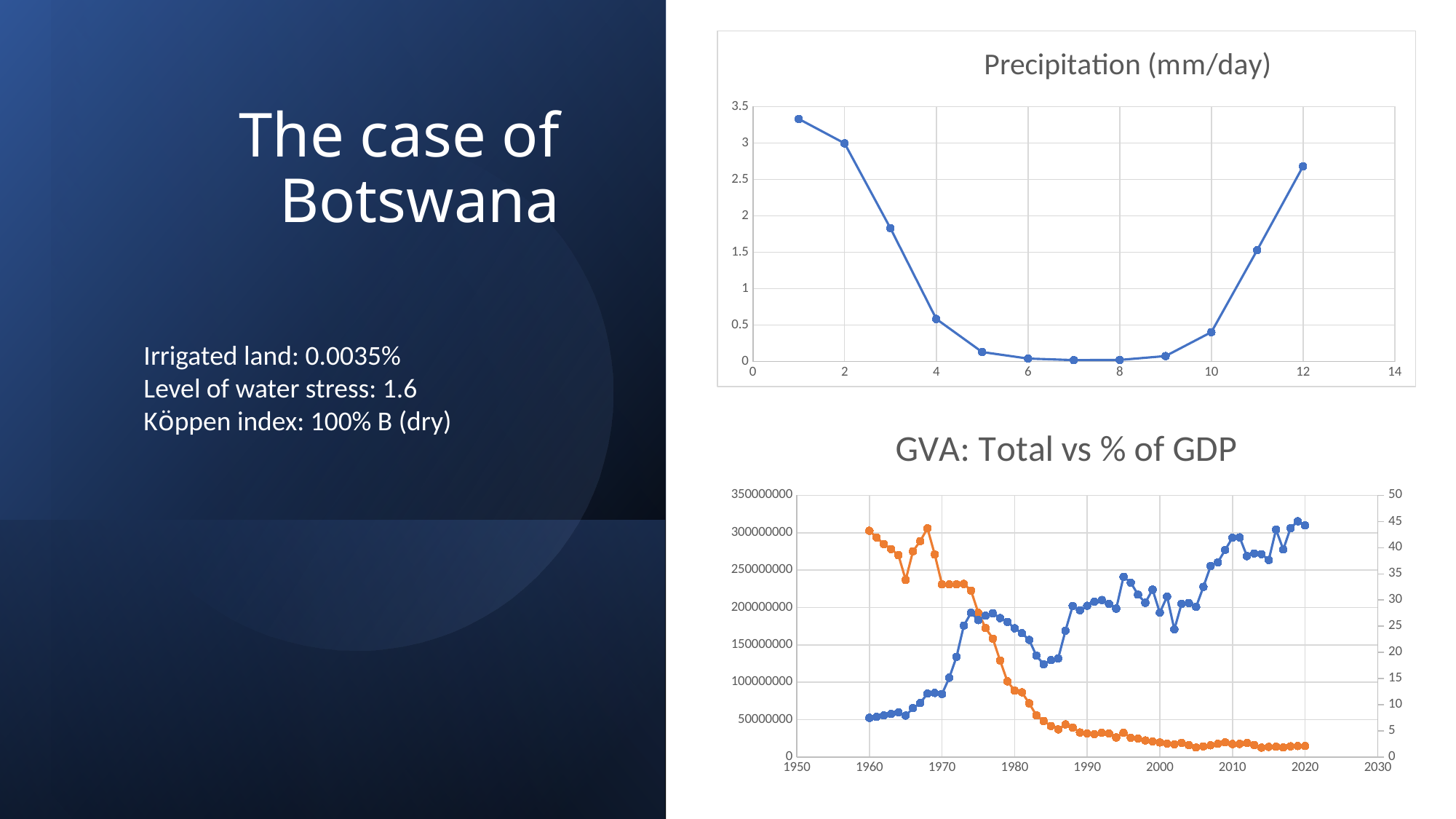
On the Precipitation (mm/day) chart, is the value at x = 1 greater or less than 3? greater What kind of chart is the Precipitation (mm/day) chart? line chart On the Precipitation (mm/day) chart, is the value at x = 10 greater or less than 1? less On the Precipitation (mm/day) chart, at which x value is precipitation highest? 1 On the Precipitation (mm/day) chart, do the values rise or fall from x = 1 to x = 7? fall On the GVA: Total vs % of GDP chart, does the orange line rise or fall overall from 1960 to 2020? fall On the GVA: Total vs % of GDP chart, is the blue line's value at 2020 greater or less than 250000000 on the left axis? greater On the Precipitation (mm/day) chart, which is larger, the value at x = 2 or the value at x = 12? x = 2 On the GVA: Total vs % of GDP chart, how many lines are plotted? 2 How many data points are plotted on the Precipitation (mm/day) chart? 12